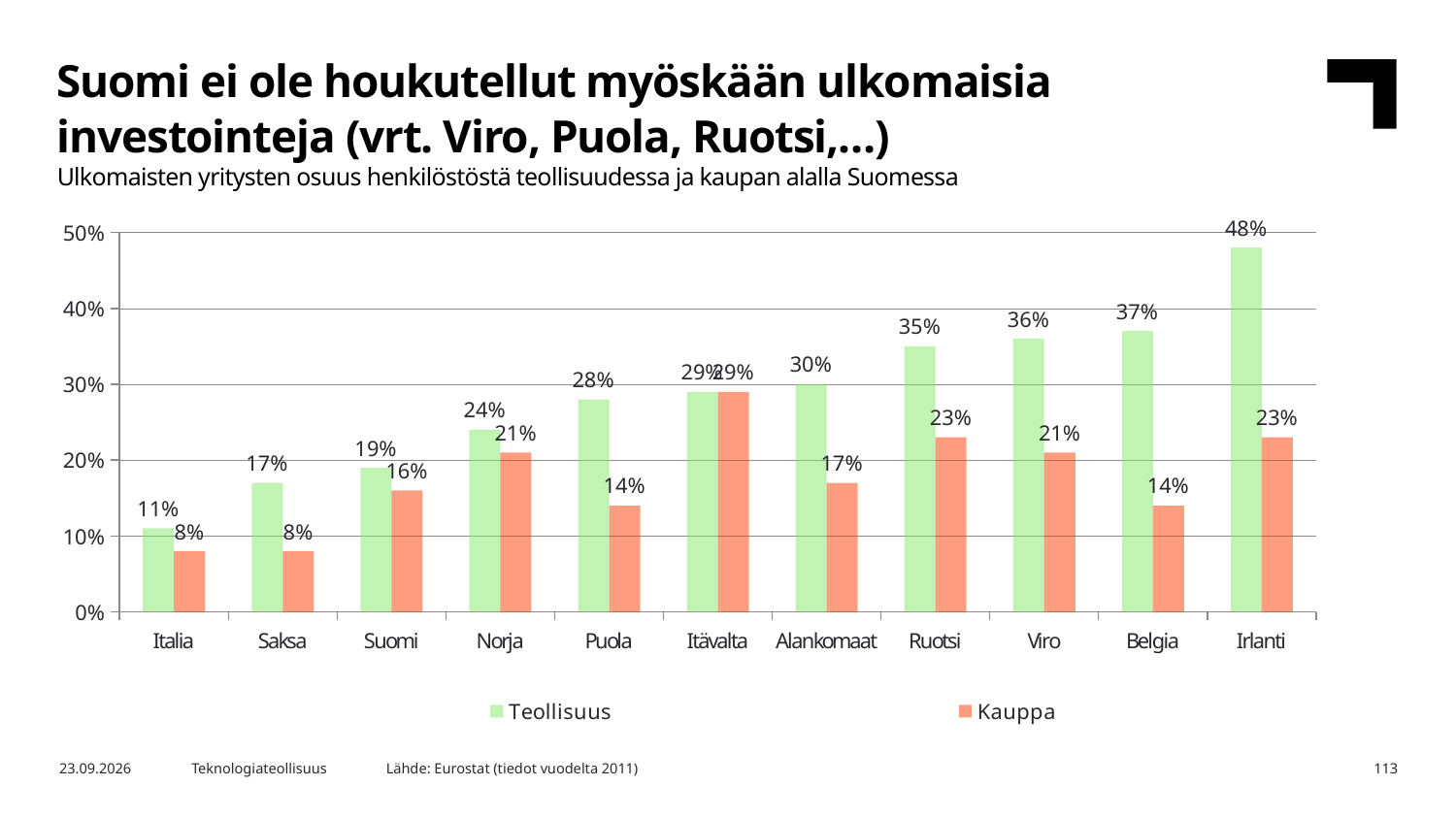
What is the difference between the Teollisuus values for Belgia and Suomi? 18 percentage points Which country has the highest Kauppa value? Itävalta How many countries are shown on the x axis? 11 Which country has the highest Teollisuus value? Irlanti Do the Teollisuus values rise or fall from Italia to Irlanti along the x axis? Rise What is the Teollisuus value for Suomi? 19% What is the Kauppa value for Viro? 21% How many series does the legend list? 2 Which country has the lowest Teollisuus value? Italia What is the Teollisuus value for Irlanti? 48% What kind of chart is shown on the slide? Bar chart Which is larger, the Kauppa value for Ruotsi or the Kauppa value for Puola? Ruotsi